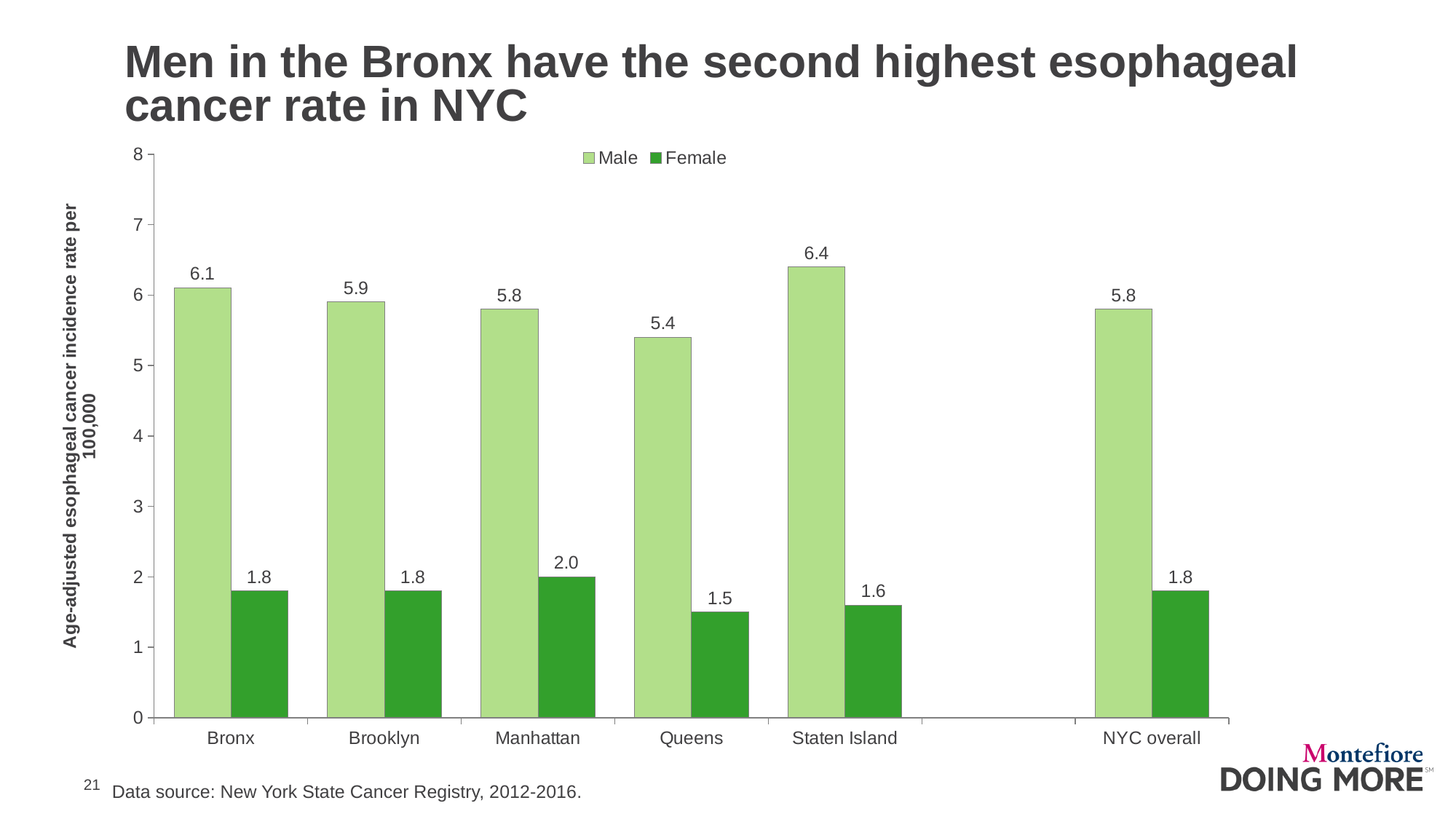
What kind of chart is shown on the slide? Bar chart Which borough has the highest Male esophageal cancer incidence rate? Staten Island What is the difference between the Male and Female rates for Queens? 3.9 What is the Male esophageal cancer incidence rate for the Bronx? 6.1 What is the Female esophageal cancer incidence rate for Manhattan? 2.0 What is the Male rate for NYC overall? 5.8 What is the data source cited on the slide? New York State Cancer Registry, 2012-2016 Which borough has the lowest Female esophageal cancer incidence rate? Queens How many categories are shown on the x axis? 6 Which is larger, the Male rate for Brooklyn or the Male rate for Queens? Brooklyn How many series does the legend list? 2 Is the Male rate for Staten Island greater or less than 6? greater